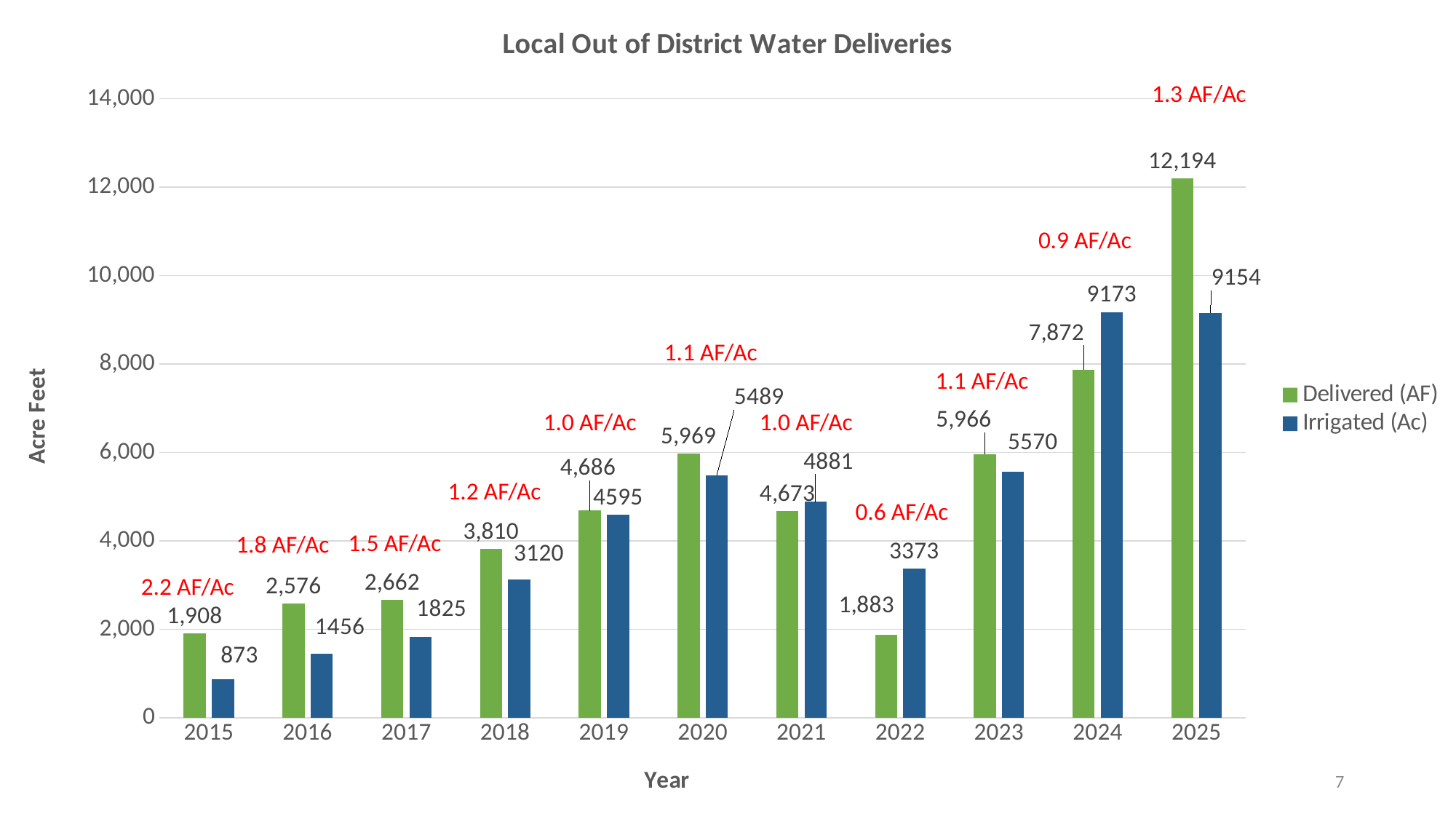
How many series does the legend list? 2 What is the title of the chart? Local Out of District Water Deliveries Which year has the highest Delivered (AF) value? 2025 Which is larger in 2022, the Delivered (AF) value or the Irrigated (Ac) value? Irrigated (Ac) How many years are shown on the x axis? 11 What kind of chart is shown? Bar chart What is the Delivered (AF) value for 2022? 1,883 What is the difference between the Delivered (AF) values for 2024 and 2023? 1,906 What is the Irrigated (Ac) value for 2018? 3120 What is the label on the y axis? Acre Feet What is the Delivered (AF) value for 2025? 12,194 Which year has the lowest Irrigated (Ac) value? 2015